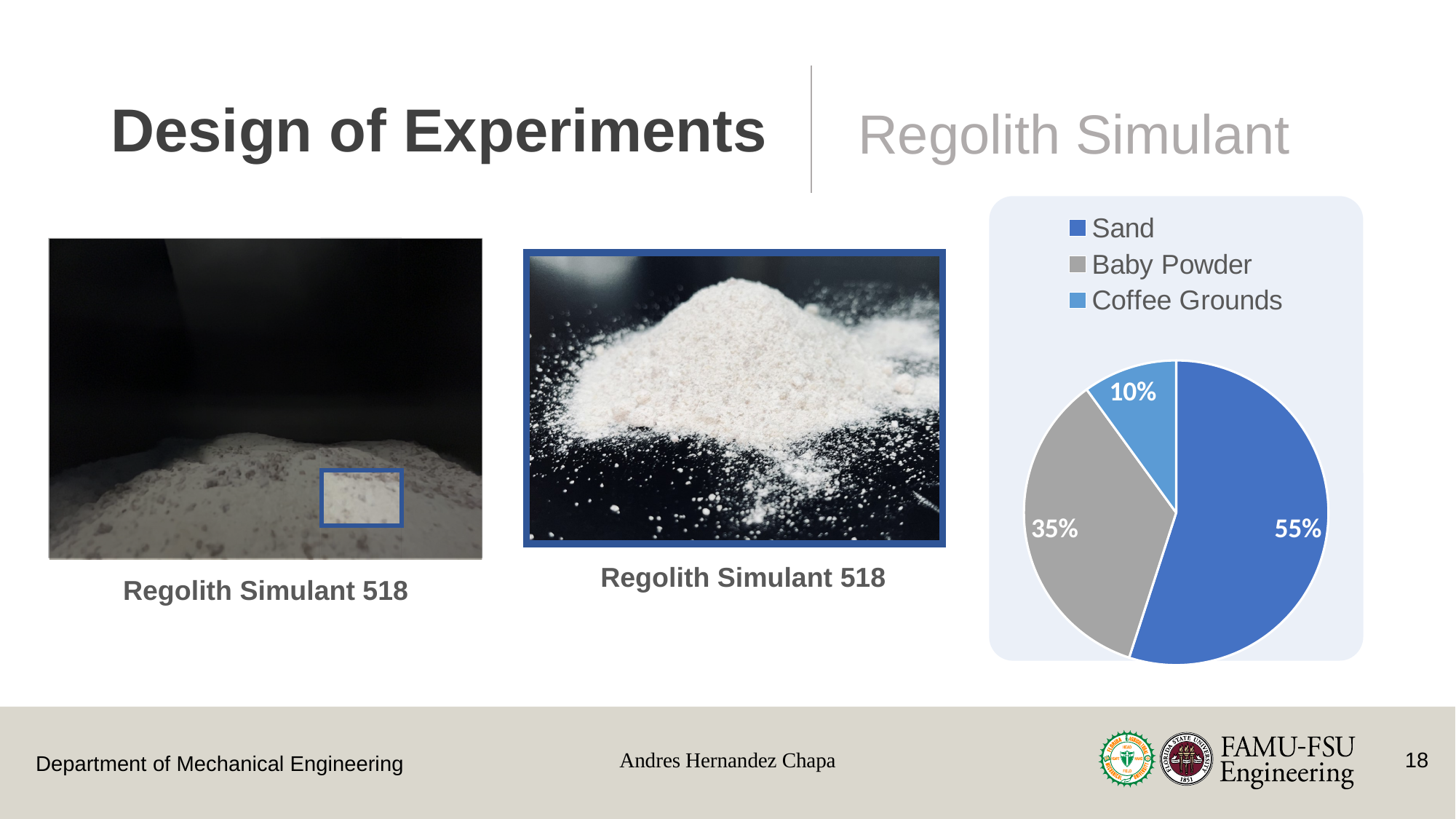
What share of the pie chart is Baby Powder? 35% What share of the pie chart is Coffee Grounds? 10% Which slice is larger, Baby Powder or Coffee Grounds? Baby Powder Which component has the smallest slice of the pie chart? Coffee Grounds How many entries does the legend of the pie chart list? 3 What share of the pie chart is Sand? 55% What kind of chart is shown on the slide? pie chart What is the difference in percentage points between the Baby Powder and Coffee Grounds slices? 25% Which component has the largest slice of the pie chart? Sand What is the difference in percentage points between the Sand and Baby Powder slices? 20% What colour is the Baby Powder slice in the pie chart? gray How many slices does the pie chart have? 3